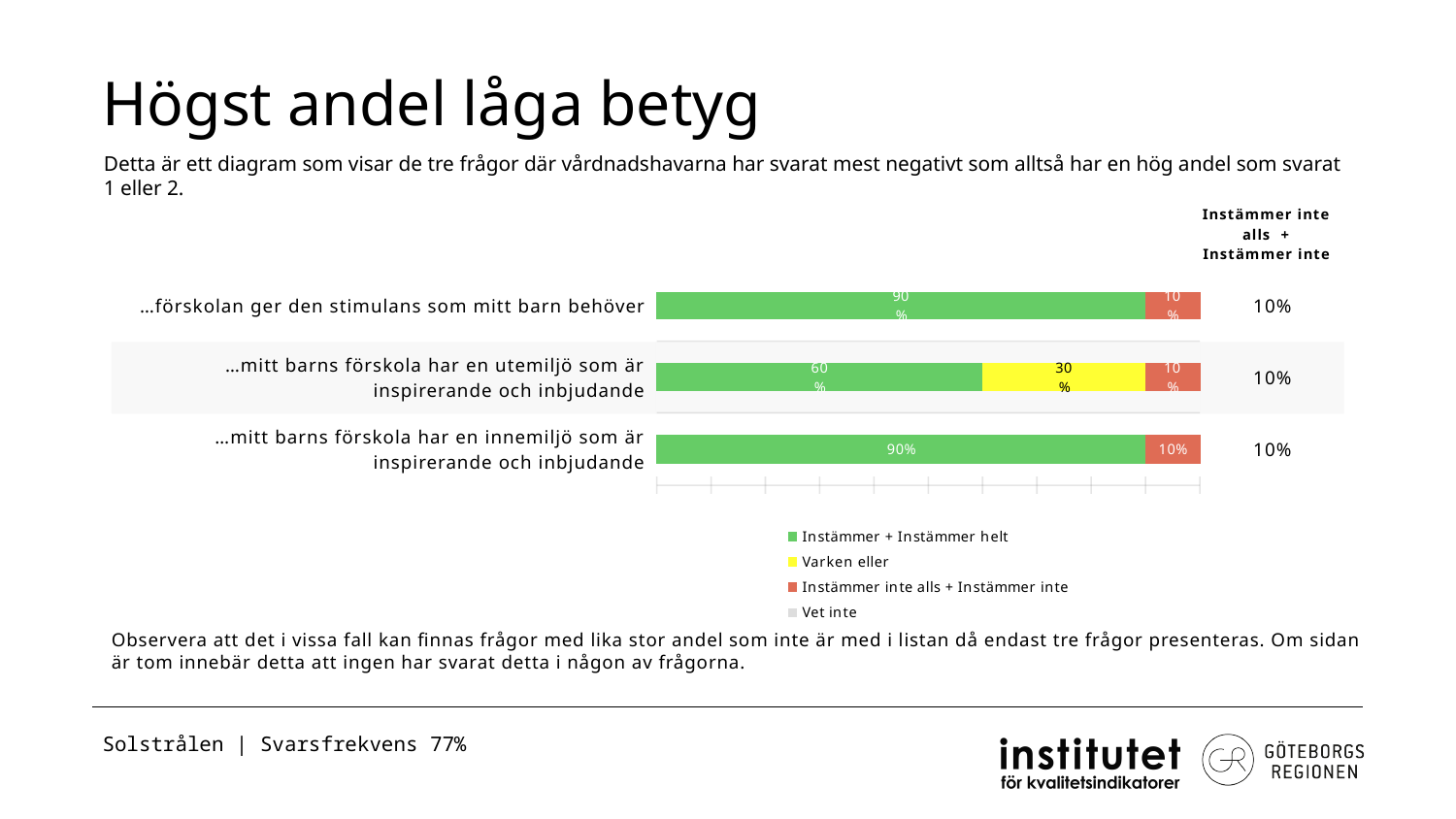
What is the value of "Instämmer inte alls + Instämmer inte" for "…förskolan ger den stimulans som mitt barn behöver"? 10% How many categories (questions) are plotted in the chart? 3 What is the total of the stacked bar for "…mitt barns förskola har en utemiljö som är inspirerande och inbjudande"? 100% Which is larger for "…mitt barns förskola har en utemiljö som är inspirerande och inbjudande": the "Varken eller" value or the "Instämmer inte alls + Instämmer inte" value? Varken eller Which category has the lowest value for "Instämmer + Instämmer helt"? …mitt barns förskola har en utemiljö som är inspirerande och inbjudande What is the value of "Varken eller" for "…mitt barns förskola har en utemiljö som är inspirerande och inbjudande"? 30% What is the difference between the "Instämmer + Instämmer helt" values for "…förskolan ger den stimulans som mitt barn behöver" and "…mitt barns förskola har en utemiljö som är inspirerande och inbjudande"? 30% What is the value of "Instämmer + Instämmer helt" for "…mitt barns förskola har en utemiljö som är inspirerande och inbjudande"? 60% How many series does the legend list? 4 What is the value of "Instämmer + Instämmer helt" for "…mitt barns förskola har en innemiljö som är inspirerande och inbjudande"? 90% What kind of chart is shown on the slide? stacked bar chart Which colour represents "Varken eller" in the legend? yellow